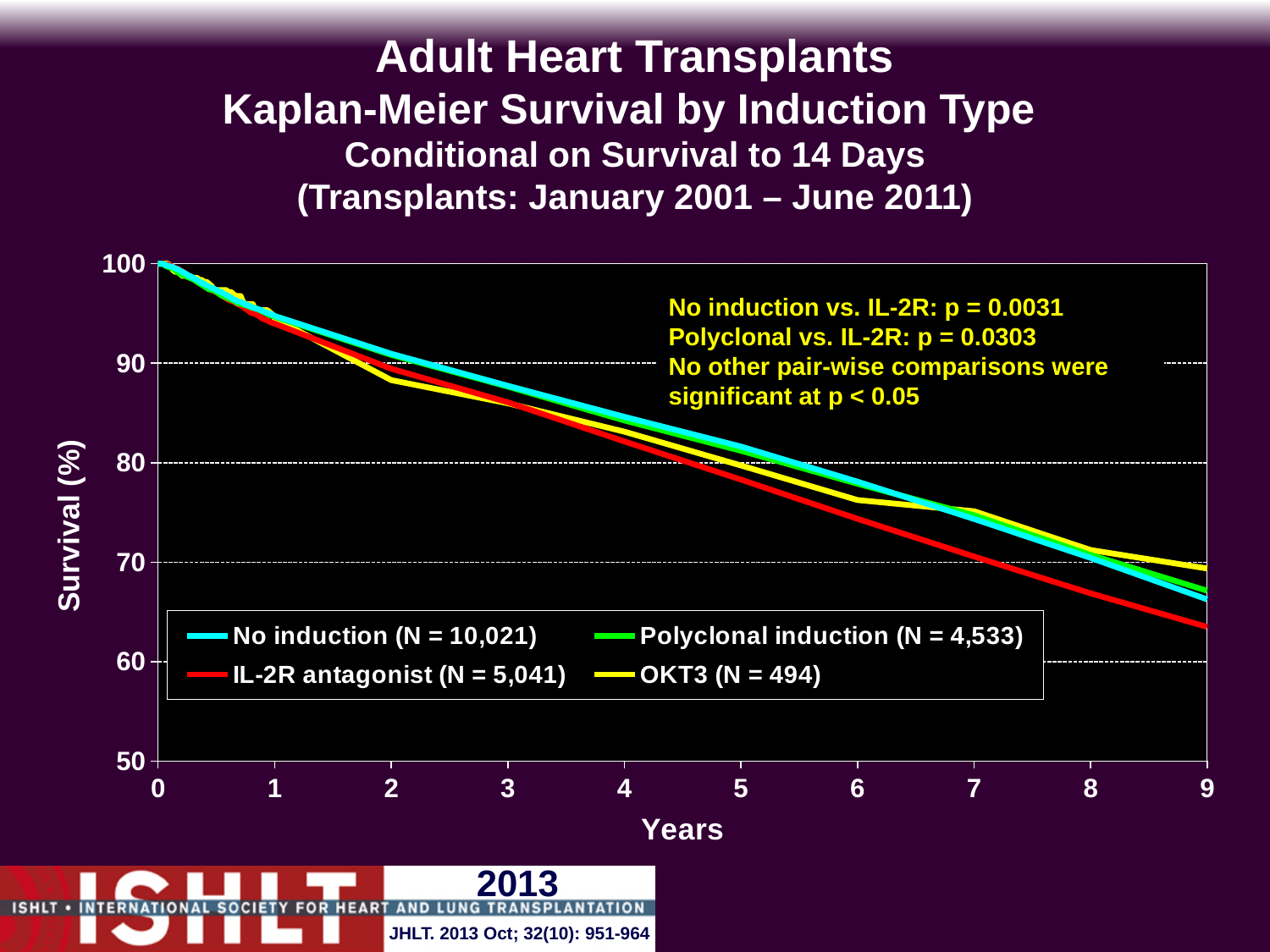
Is the survival value for No induction at 3 years greater or less than 90? less Is the survival value for IL-2R antagonist at 6 years greater or less than 80? less Is the survival value for IL-2R antagonist at 9 years greater or less than 70? less How many series does the legend list? 4 What is the survival value for all groups at year 0? 100 What p-value is given for No induction vs. IL-2R? p = 0.0031 What kind of chart is shown on the slide? line chart At 9 years, which is higher: survival for No induction or for IL-2R antagonist? No induction Do the survival curves rise or fall as years increase? fall What is the N for the No induction group shown in the legend? 10,021 Which induction group has the lowest survival at 9 years? IL-2R antagonist